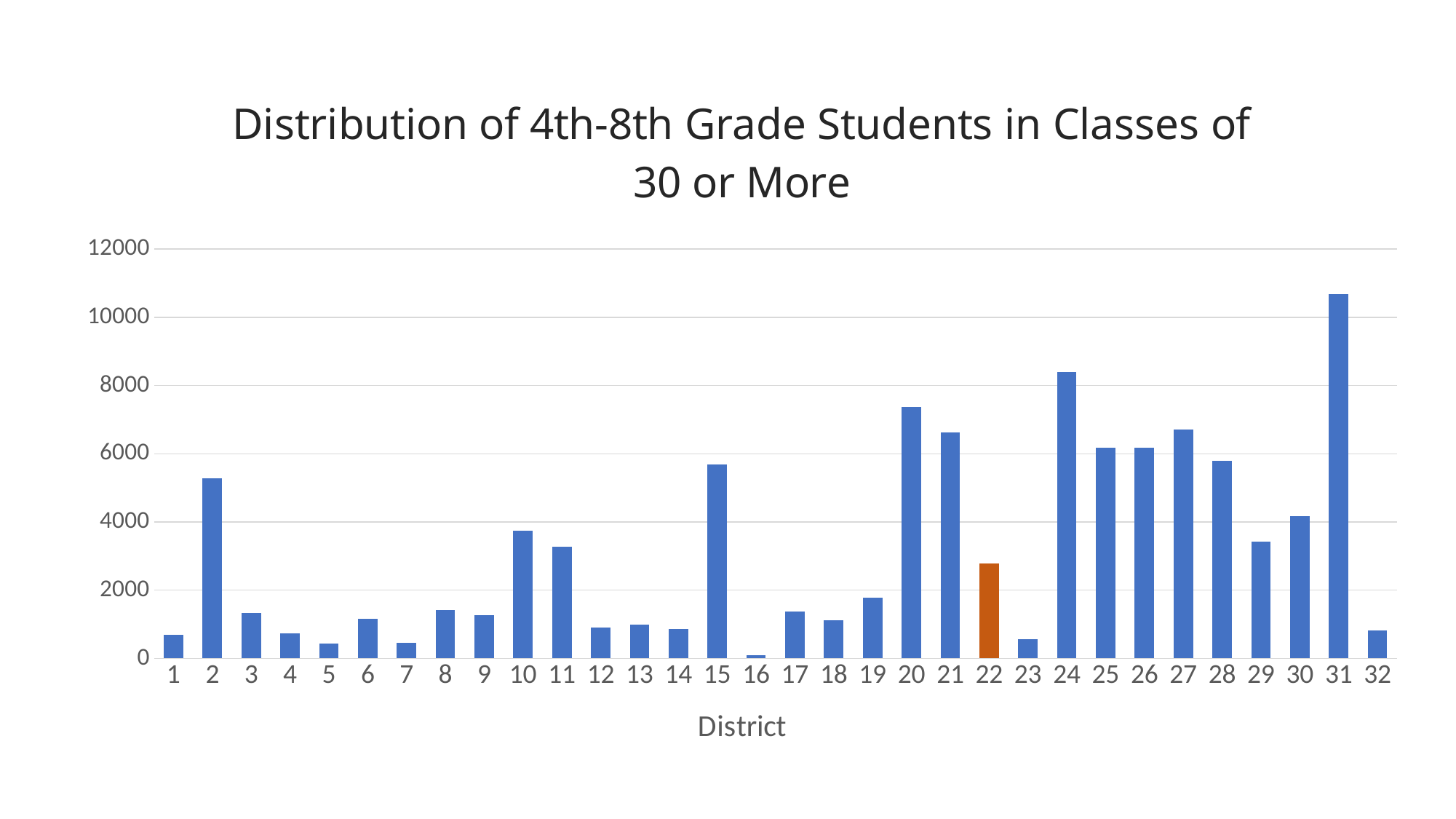
Is the value for district 20 greater or less than 8000? less Which has the larger value, district 24 or district 20? district 24 What kind of chart is shown on the slide? bar chart How many districts are shown on the x axis? 32 Which district has the highest value? 31 Is the value for district 31 greater or less than 10000? greater Which has the larger value, district 2 or district 10? district 2 Which district has the lowest value? 16 Is the value for district 16 greater or less than 2000? less Which district's bar is highlighted in orange? 22